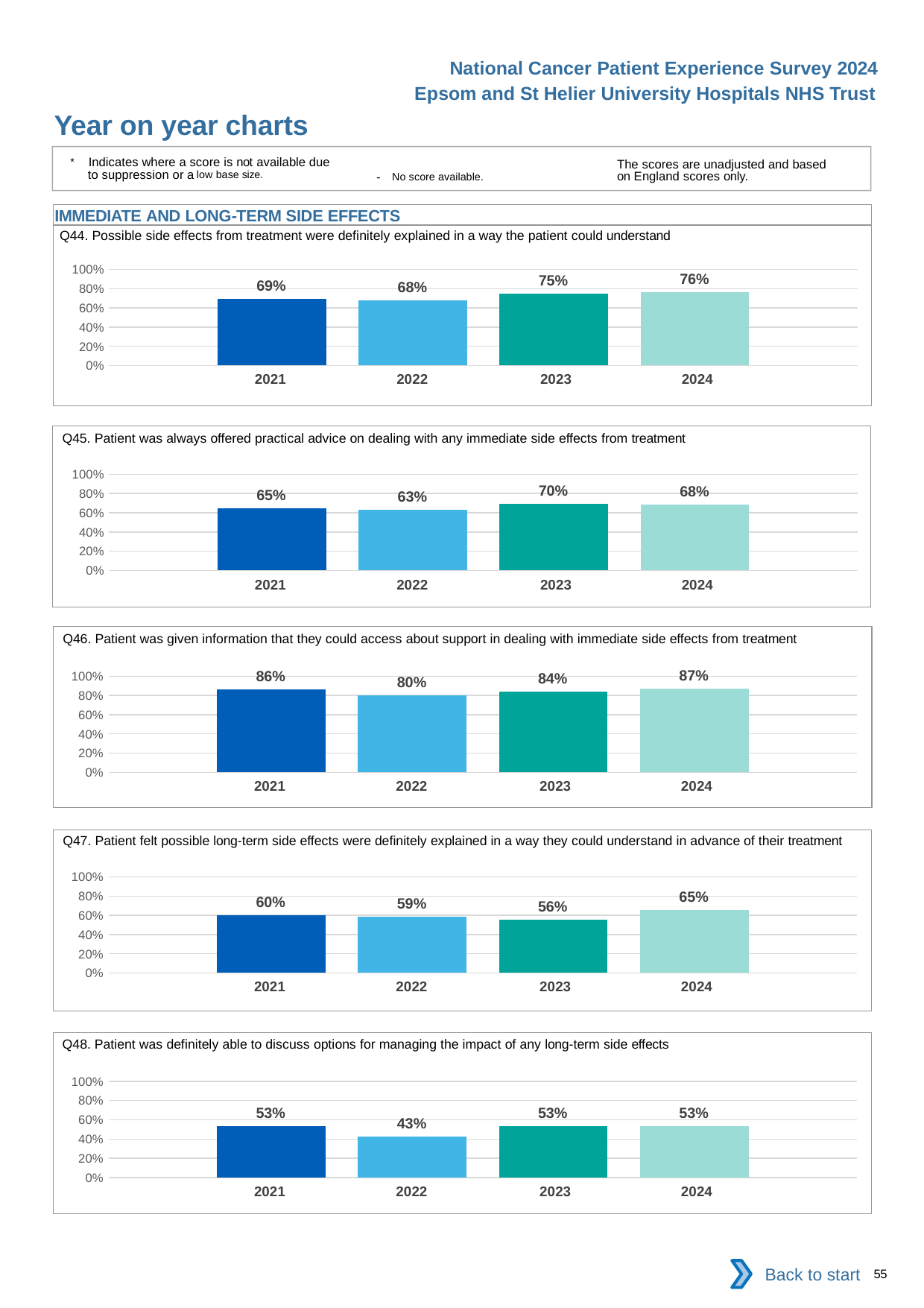
How many years are shown in the Q46 chart? 4 In the Q46 chart, what is the difference between the 2021 value and the 2022 value? 6% What kind of chart is the Q47 chart? bar chart In the Q45 chart, is the value for 2022 greater or less than 80%? less What is the section heading above the Q44 chart? IMMEDIATE AND LONG-TERM SIDE EFFECTS In the Q45 chart, which year has the highest value? 2023 In the Q44 chart, does the value rise or fall from 2022 to 2024? rise In the Q44 chart, is the value for 2023 larger or smaller than the value for 2022? larger In the Q44 chart, what is the value for 2024? 76% In the Q48 chart, what is the value for 2022? 43% In the Q46 chart, which year has the lowest value? 2022 In the Q47 chart, what is the difference between the 2024 value and the 2023 value? 9%